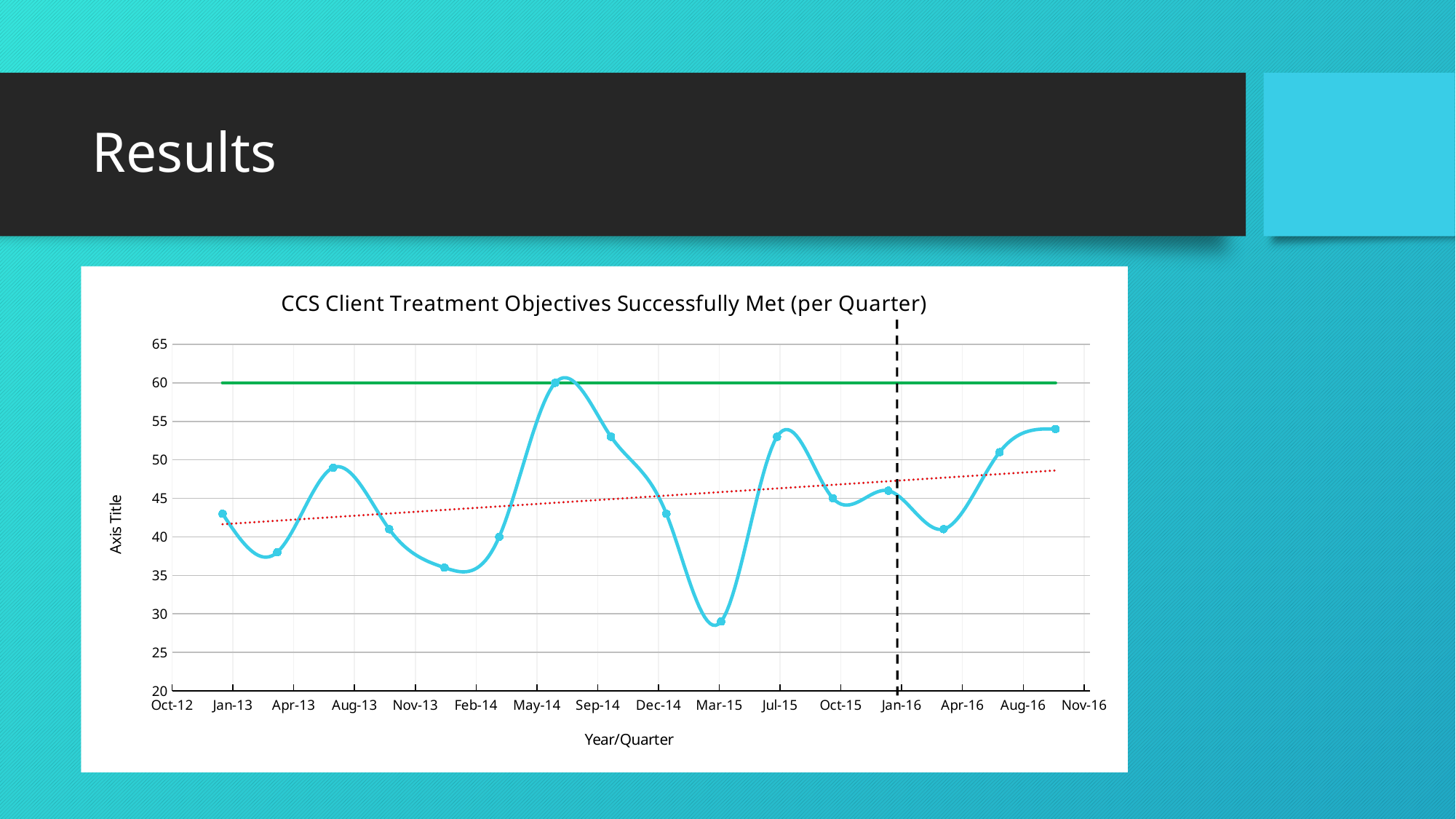
What is the title of the chart? CCS Client Treatment Objectives Successfully Met (per Quarter) Is the value of the first data point (near Jan-13) greater or less than 40? greater What kind of chart is shown on the slide? line chart What is the label of the x axis? Year/Quarter Around which x-axis label does the lowest data point of the blue line occur? Mar-15 Does the dotted red trend line rise or fall from left to right? rises Is the value of the data point at Mar-15 greater or less than 35? less Is the value of the highest data point (between May-14 and Sep-14) greater or less than 55? greater At what value on the y axis is the solid green horizontal line drawn? 60 Which is larger, the data point near Jul-15 or the data point at Mar-15? the data point near Jul-15